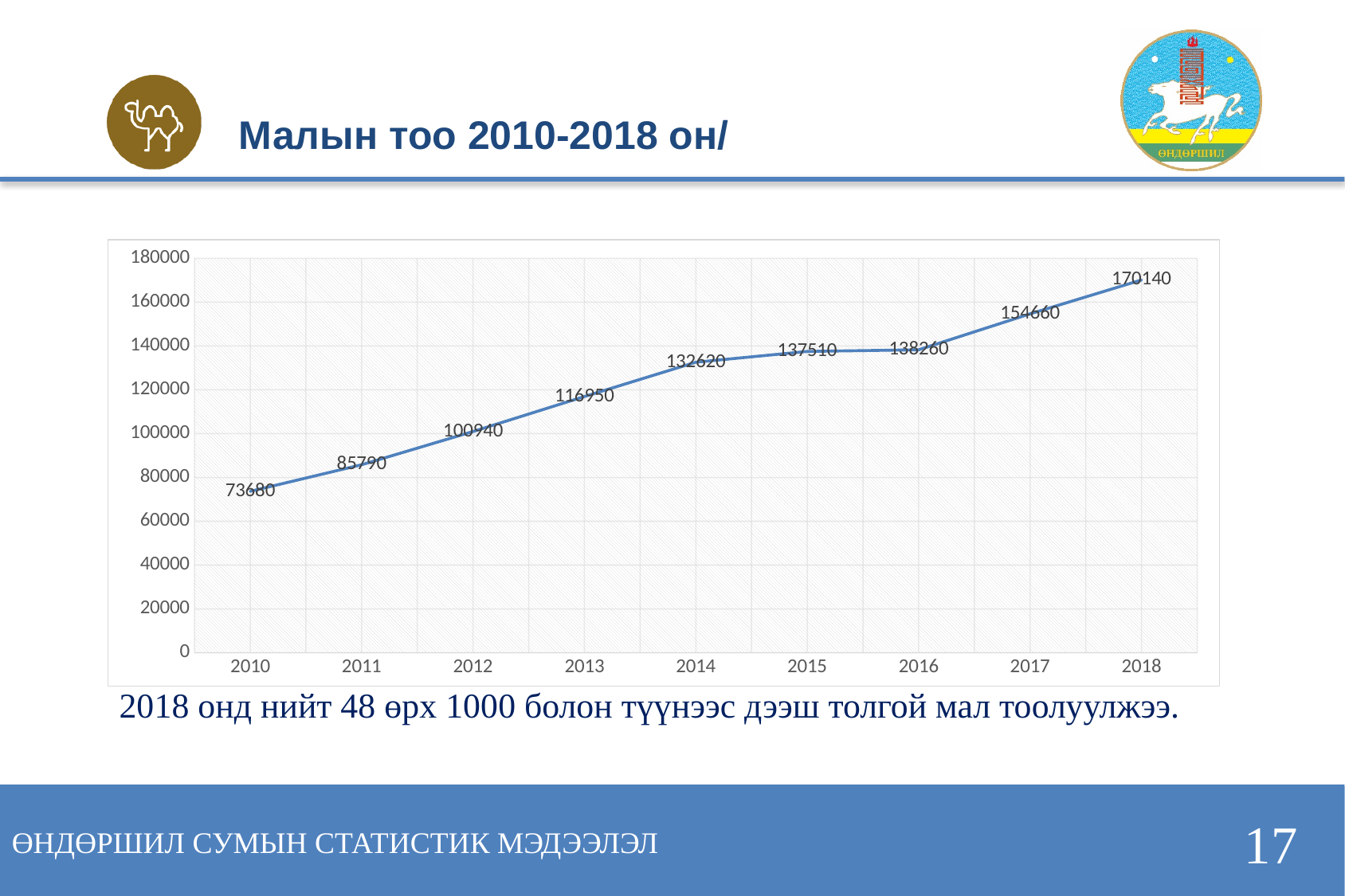
What is the difference between the values for 2018 and 2017? 15480 What kind of chart is shown on the slide? line chart Which is larger, the value for 2013 or the value for 2012? 2013 What is the value for 2010? 73680 Which year has the highest value? 2018 What is the value for 2017? 154660 Is the value for 2015 greater or less than 120000? greater Do the values rise or fall from 2010 to 2018? rise What is the difference between the values for 2011 and 2010? 12110 How many years are plotted on the x axis? 9 Which year has the lowest value? 2010 What is the value for 2014? 132620